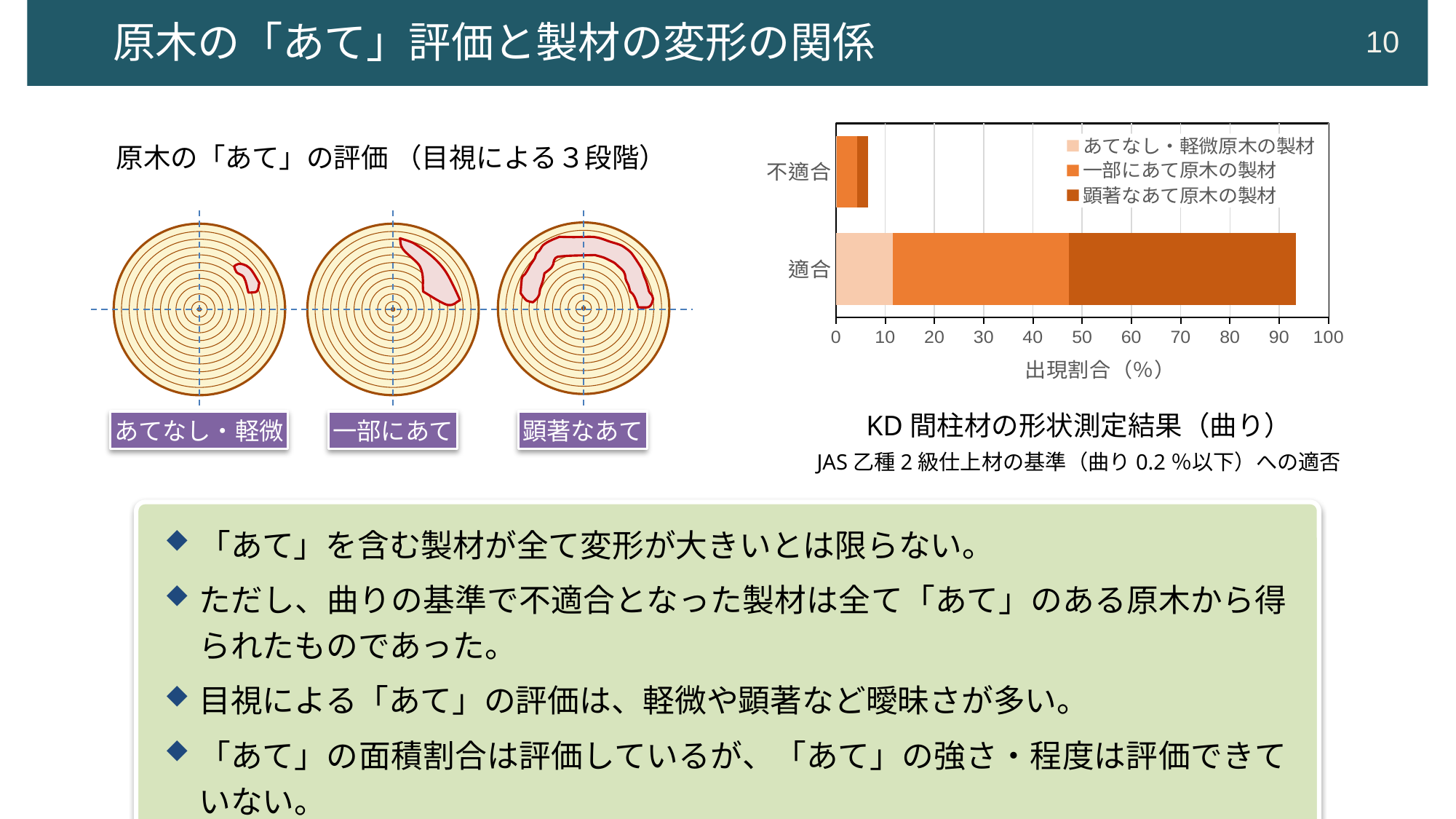
How many categories are shown on the vertical axis of the bar chart? 2 Is the あてなし・軽微原木の製材 segment of the 適合 bar greater or less than 20? less Which legend series has no segment in the 不適合 bar? あてなし・軽微原木の製材 In the 適合 bar, which series has the largest segment? 顕著なあて原木の製材 Is the total value of the 不適合 bar greater or less than 10? less Is the total value of the 適合 bar greater or less than 90? greater How many series does the legend of the bar chart list? 3 Which category has the longer total bar in the chart, 適合 or 不適合? 適合 In the 不適合 bar, which segment is larger, 一部にあて原木の製材 or 顕著なあて原木の製材? 一部にあて原木の製材 What kind of chart is shown on the right side of the slide? Stacked bar chart What is the title of the horizontal axis of the bar chart? 出現割合（%）